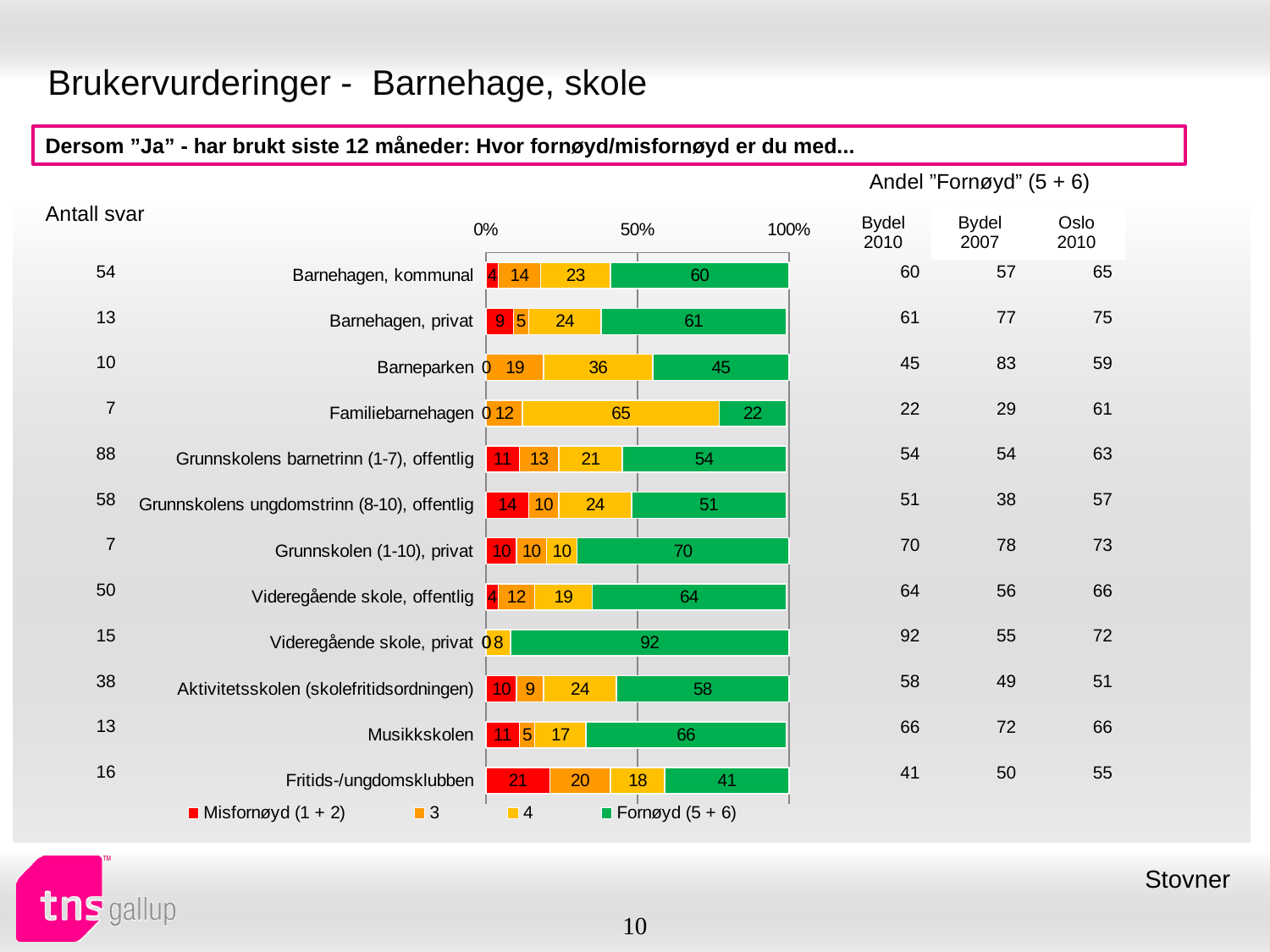
What kind of chart is shown on the slide? Stacked bar chart How many categories are shown in the chart? 12 What is the first entry in the chart legend? Misfornøyd (1 + 2) What is the total of the stacked bar for Fritids-/ungdomsklubben? 100 Which category has the highest Fornøyd (5 + 6) value? Videregående skole, privat What is the Fornøyd (5 + 6) value for Musikkskolen? 66 What is the difference between the Fornøyd (5 + 6) values for Barnehagen, privat and Barnehagen, kommunal? 1 How many series does the legend list? 4 What is the value of the '4' series for Barneparken? 36 Which category has the lowest Fornøyd (5 + 6) value? Familiebarnehagen Which category has the highest Misfornøyd (1 + 2) value? Fritids-/ungdomsklubben Which has a larger Misfornøyd (1 + 2) value: Fritids-/ungdomsklubben or Grunnskolens ungdomstrinn (8-10), offentlig? Fritids-/ungdomsklubben